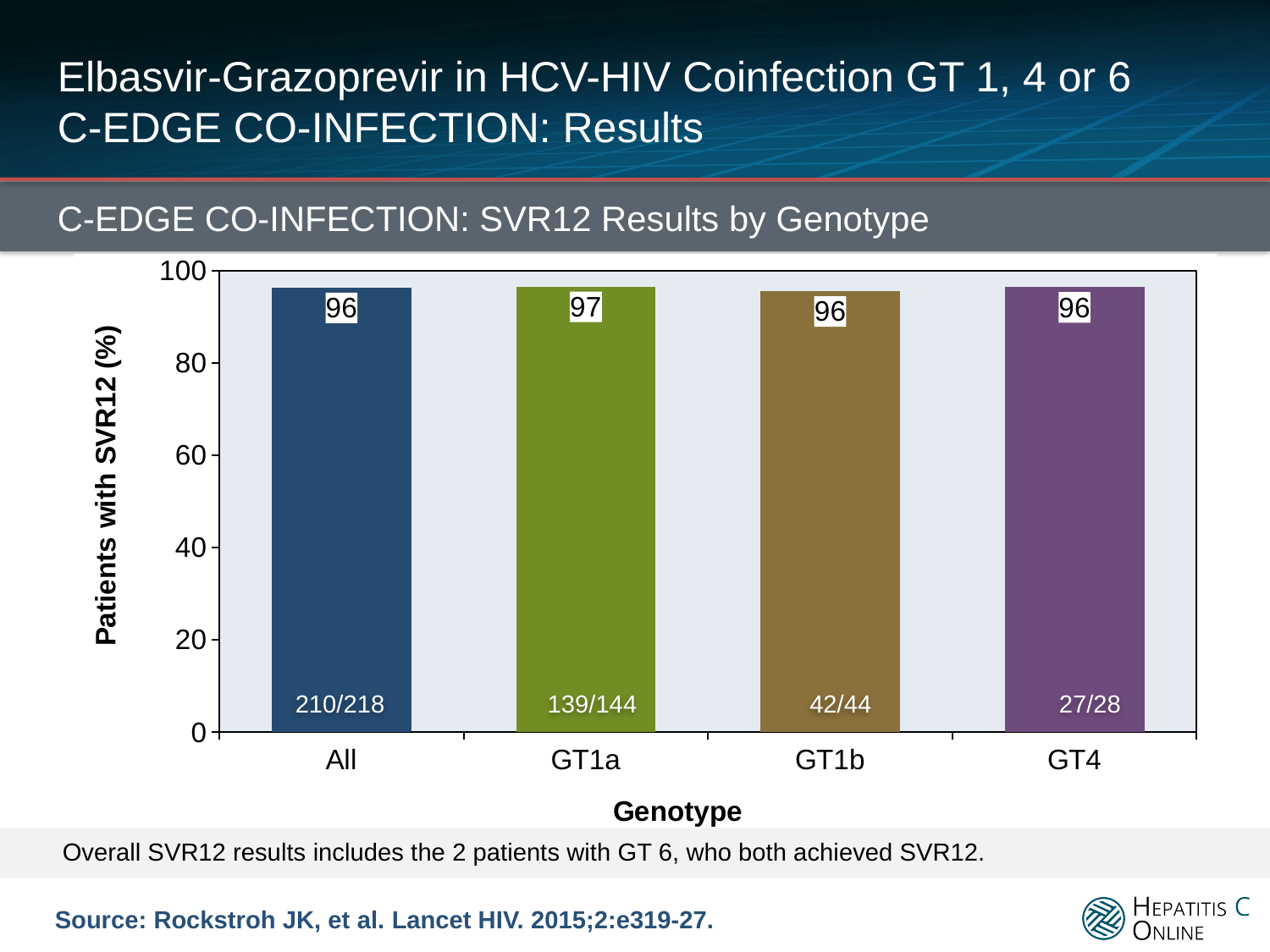
What fraction of patients is shown inside the All bar? 210/218 Which genotype group has the highest SVR12 rate? GT1a Which has a higher SVR12 rate, GT1a or GT4? GT1a What is the label of the y axis? Patients with SVR12 (%) How many genotype groups are shown on the x axis? 4 Is the SVR12 rate for GT1b greater or less than 80? greater What fraction of patients is shown inside the GT1b bar? 42/44 What is the SVR12 rate for GT1a? 97 What kind of chart is shown on the slide? Bar chart What is the difference in SVR12 rate between GT1a and GT1b? 1 What is the SVR12 rate for GT4? 96 What is the SVR12 rate for the All group? 96